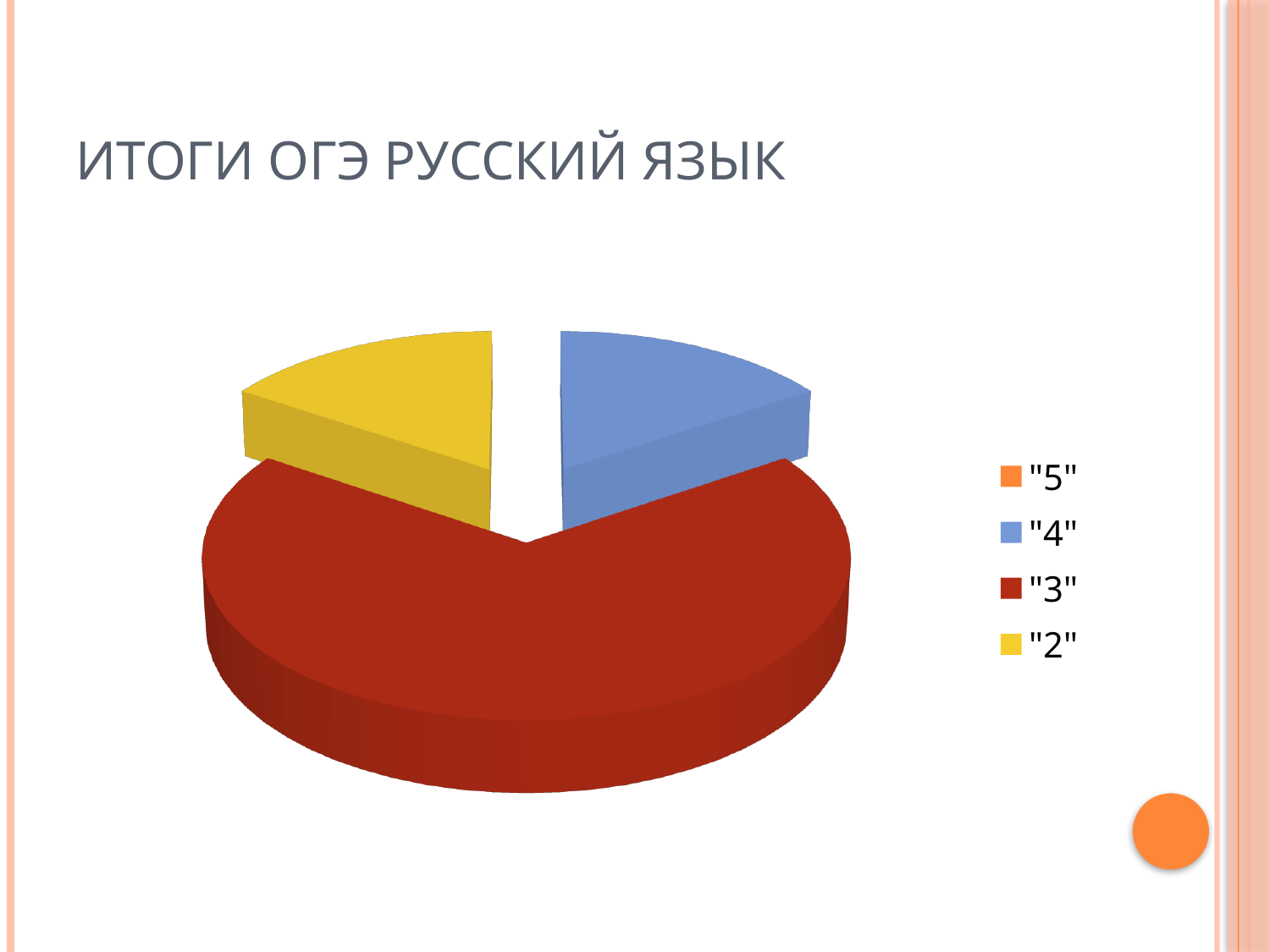
Which slice is larger, "3" or "2"? "3" Which category has the largest slice of the pie? "3" What kind of chart is shown on the slide? pie chart What colour is the slice for "3"? red Which slice is larger, "3" or "4"? "3" How many entries does the legend list? 4 What is the title of the slide? ИТОГИ ОГЭ РУССКИЙ ЯЗЫК